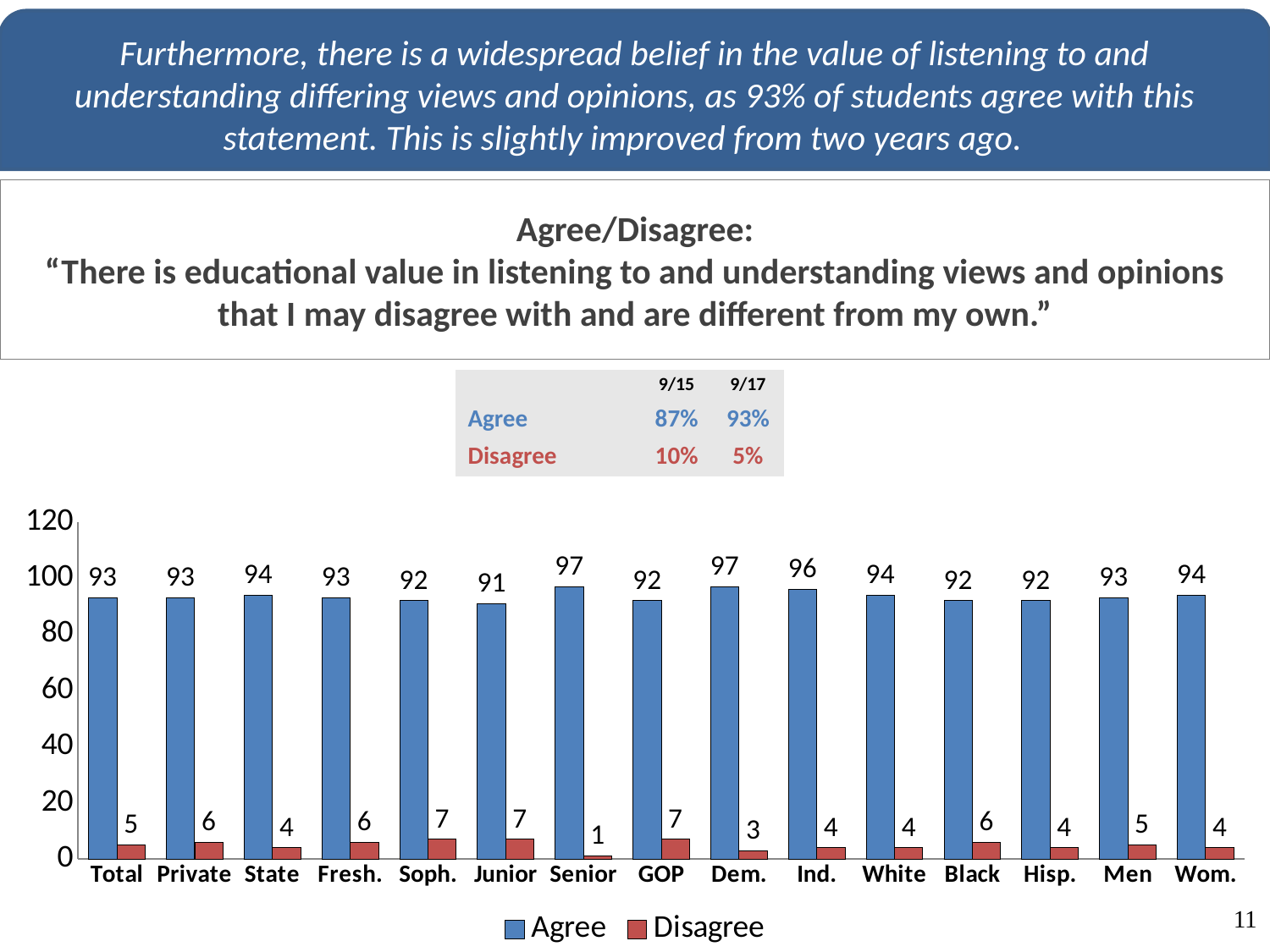
Which category has the lowest Agree value? Junior What are the two series named in the chart legend? Agree and Disagree What kind of chart is shown on the slide? bar chart What is the Disagree value for Soph.? 7 How many categories are shown on the x axis of the chart? 15 What is the difference between the Agree values for Senior and Junior? 6 What is the Agree value for Senior? 97 What is the Agree value for Ind.? 96 How many series does the chart legend list? 2 What is the Disagree value for Dem.? 3 Which is larger, the Disagree value for GOP or the Disagree value for Dem.? GOP Which category has the lowest Disagree value? Senior